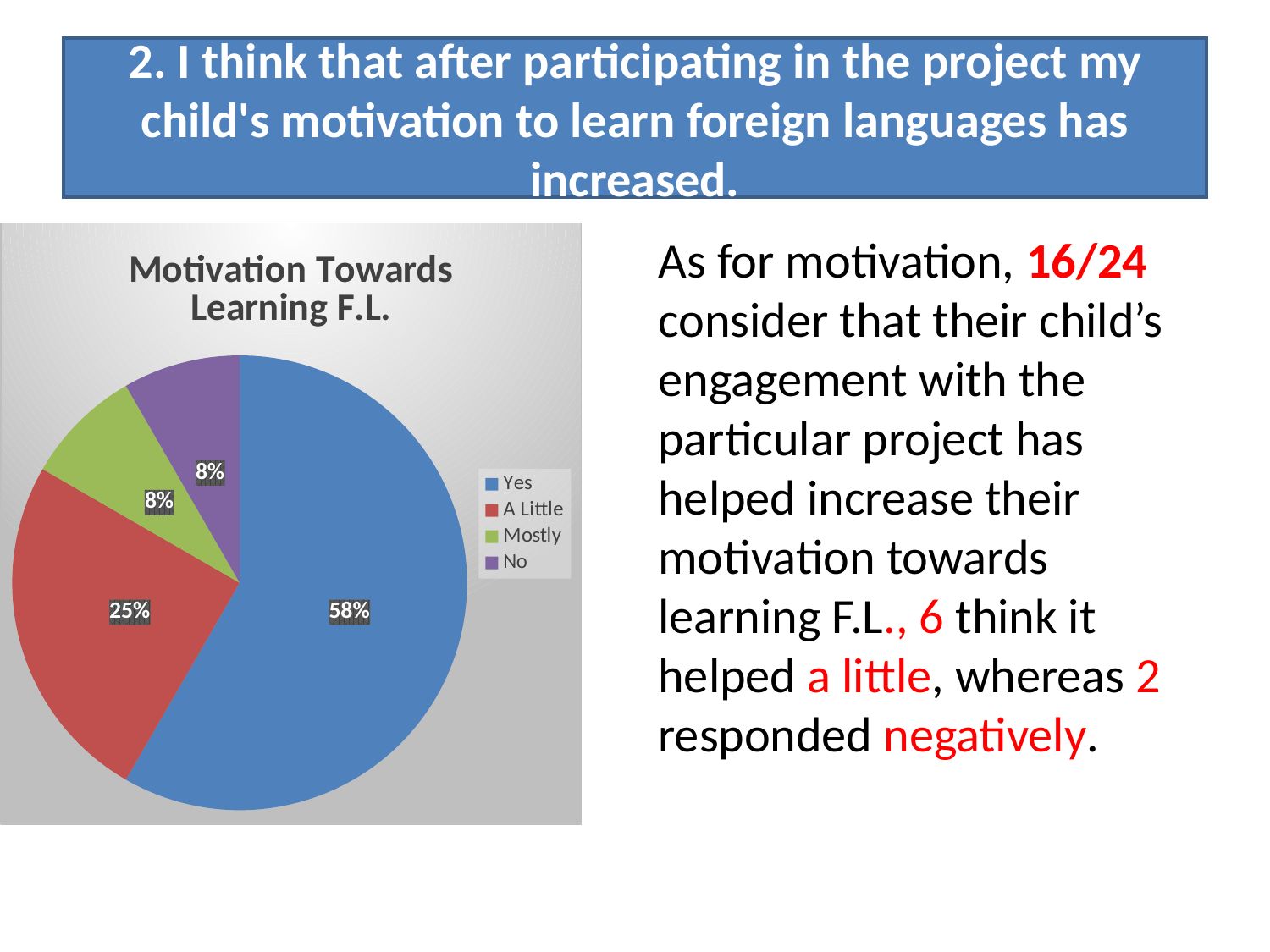
What share of the pie does the 'A Little' slice represent? 25% What is the title of the chart? Motivation Towards Learning F.L. What share of the pie does the 'Yes' slice represent? 58% Which is larger, the 'A Little' slice or the 'Mostly' slice? A Little Which categories are listed in the legend of the chart? Yes, A Little, Mostly, No Which category has the largest slice of the pie? Yes What is the difference in percentage points between the 'Yes' slice and the 'A Little' slice? 33 Is the share for 'Yes' greater or less than 50%? greater What share of the pie does the 'Mostly' slice represent? 8% What kind of chart is shown on the slide? pie chart How many categories does the pie chart show? 4